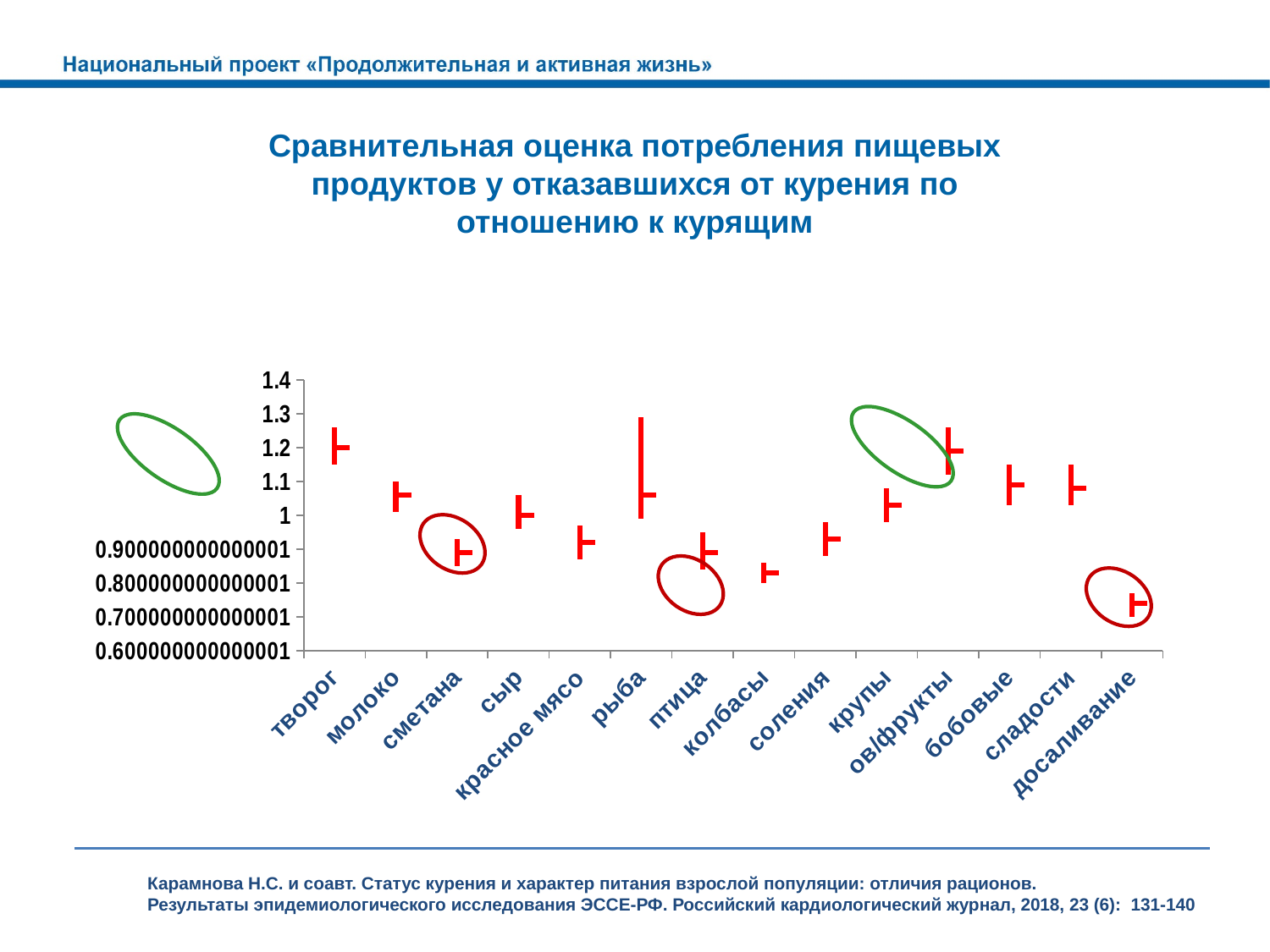
Which has the larger value, колбасы or сыр? сыр Which has the larger value, творог or досаливание? творог Is the value for сметана greater or less than 1? less Is the value for ов/фрукты greater or less than 1.1? greater Which has the larger value, сметана or бобовые? бобовые Is the value for досаливание greater or less than 0.8? less What is the first category listed on the x axis of the chart? творог Which category has the lowest value on the chart? досаливание How many food categories are shown on the x axis of the chart? 14 What is the highest tick value shown on the y axis of the chart? 1.4